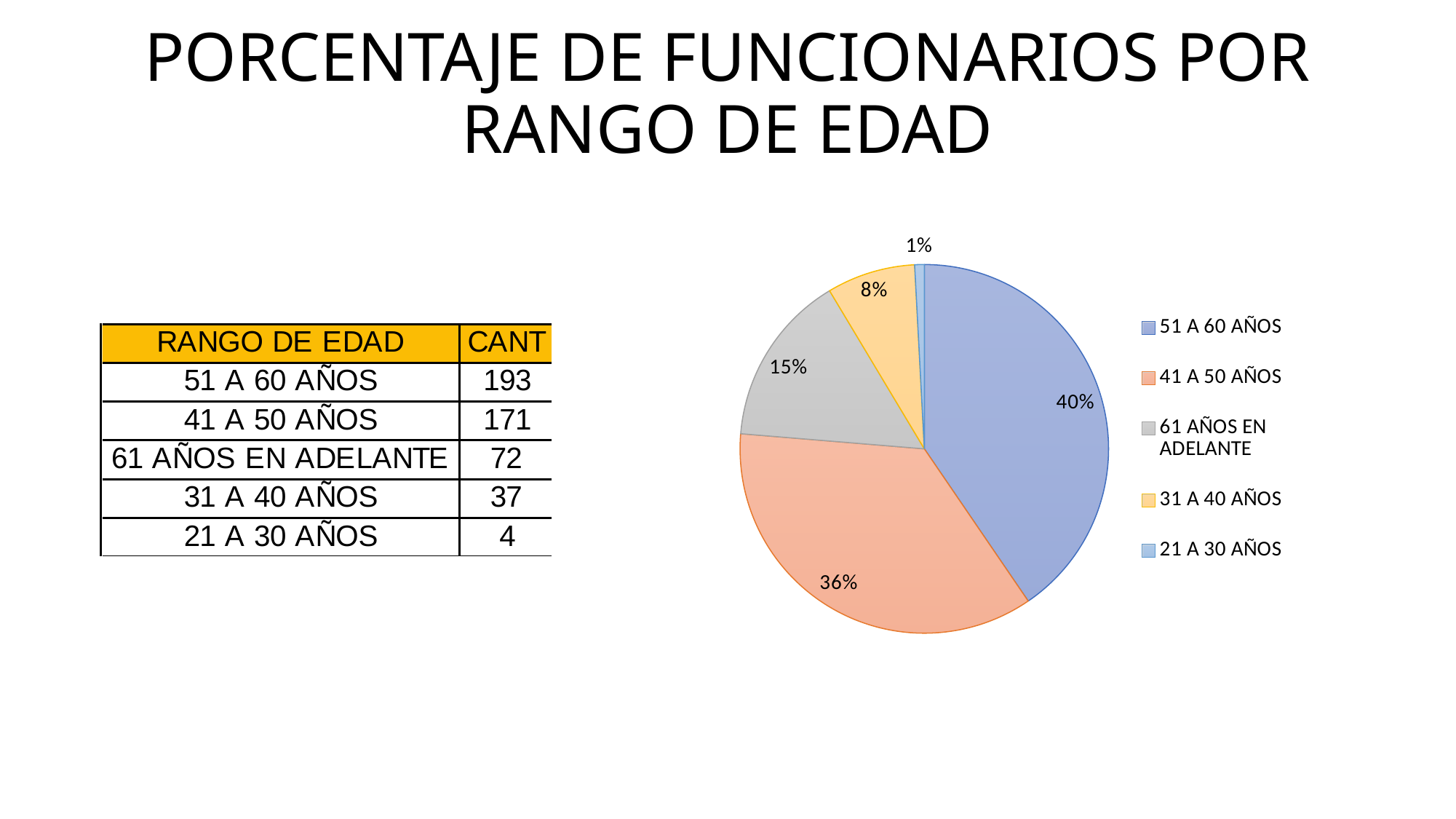
What percentage of the pie chart does the 61 AÑOS EN ADELANTE slice represent? 15% What percentage of the pie chart does the 41 A 50 AÑOS slice represent? 36% What is the difference in percentage points between the 51 A 60 AÑOS slice and the 41 A 50 AÑOS slice? 4 percentage points What percentage of the pie chart does the 21 A 30 AÑOS slice represent? 1% What kind of chart is shown on the slide? Pie chart Which age range has the smallest slice in the pie chart? 21 A 30 AÑOS What colour is the 41 A 50 AÑOS slice in the pie chart? Orange Which slice is larger in the pie chart, 61 AÑOS EN ADELANTE or 31 A 40 AÑOS? 61 AÑOS EN ADELANTE Which age range has the largest slice in the pie chart? 51 A 60 AÑOS How many slices does the pie chart have? 5